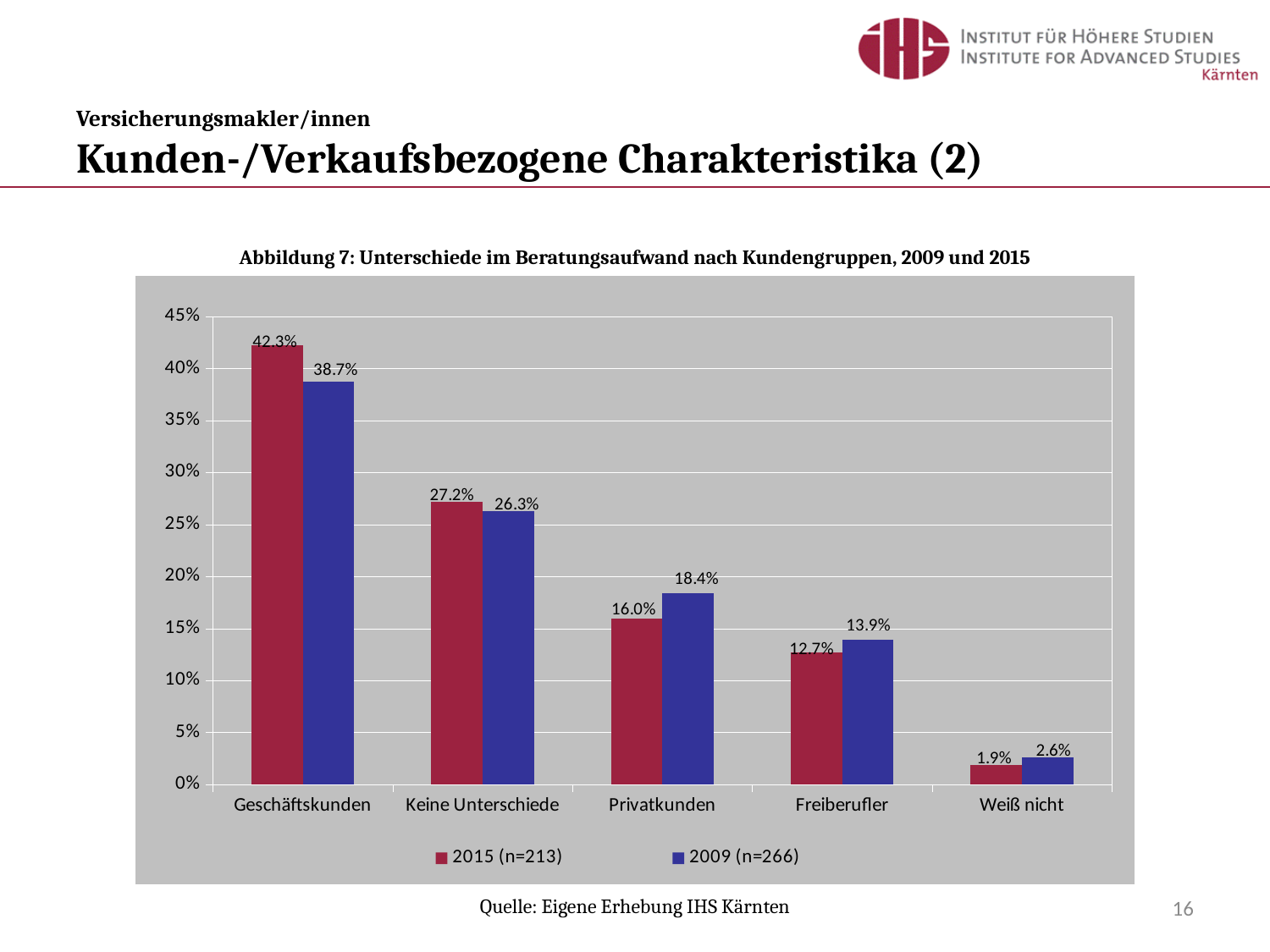
What is the value for Geschäftskunden in the 2015 (n=213) series? 42.3% What kind of chart is shown on the slide? bar chart Is the 2015 (n=213) value for Keine Unterschiede greater or less than 25%? greater Which category has the highest value in the 2009 (n=266) series? Geschäftskunden What is the value for Weiß nicht in the 2015 (n=213) series? 1.9% What is the difference between the 2015 (n=213) and 2009 (n=266) values for Geschäftskunden? 3.6% What is the value for Privatkunden in the 2009 (n=266) series? 18.4% Which category has the lowest value in the 2015 (n=213) series? Weiß nicht What is the title of the chart? Abbildung 7: Unterschiede im Beratungsaufwand nach Kundengruppen, 2009 und 2015 For Freiberufler, which series has the larger value, 2015 (n=213) or 2009 (n=266)? 2009 (n=266) How many categories are shown on the x axis? 5 How many series does the legend list? 2